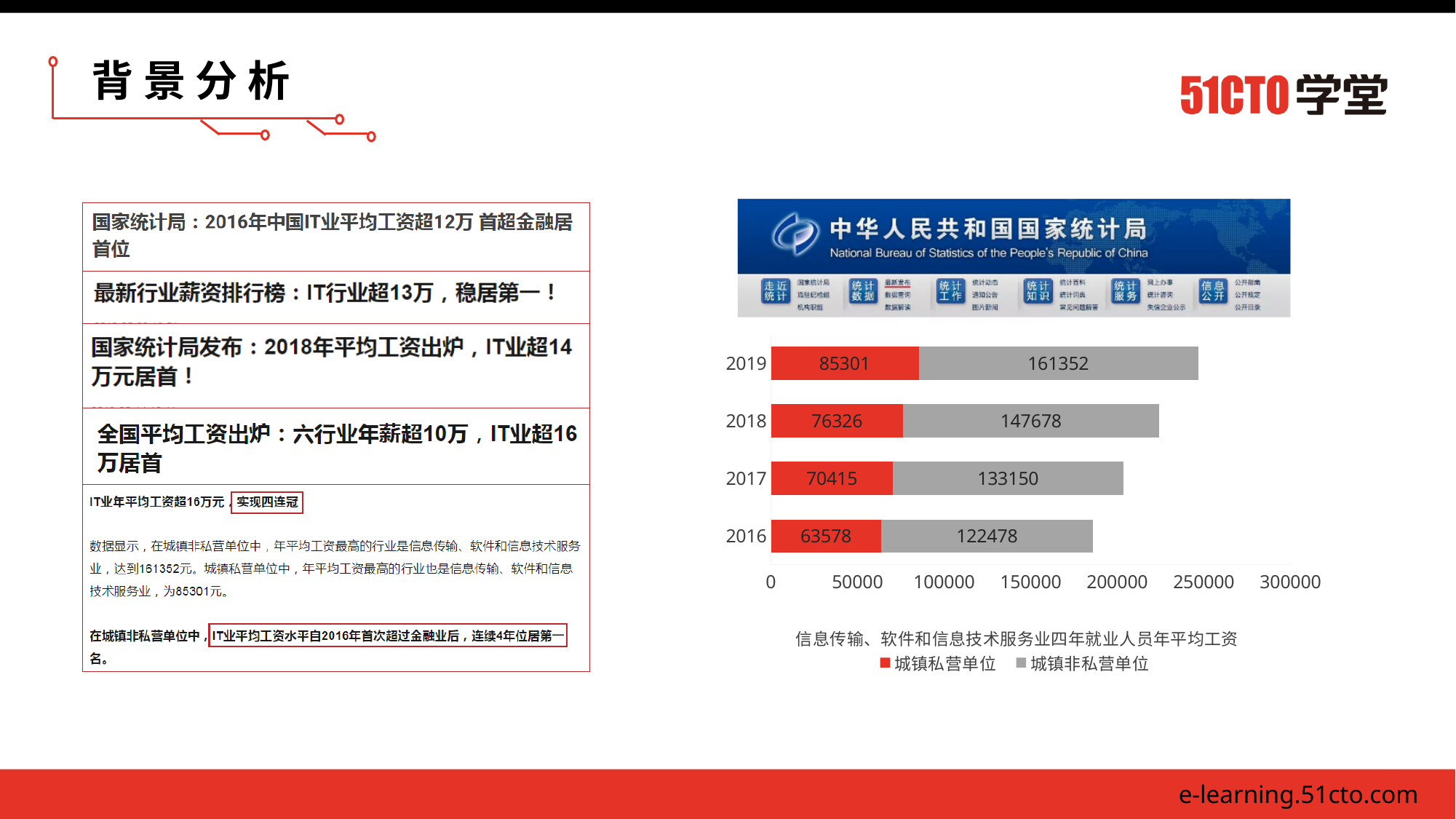
What is the total of the stacked bar for 2018? 224004 Which year has the highest value for 城镇非私营单位? 2019 What is the value for 城镇非私营单位 in 2017? 133150 How many years are shown on the chart? 4 Which is larger: 城镇私营单位 in 2018 or 城镇私营单位 in 2017? 城镇私营单位 in 2018 How many series does the legend list? 2 What is the difference between 城镇非私营单位 and 城镇私营单位 in 2019? 76051 What is the total of the stacked bar for 2016? 186056 What is the value for 城镇私营单位 in 2016? 63578 Which year has the lowest value for 城镇私营单位? 2016 What kind of chart is shown on the slide? Stacked bar chart What is the value for 城镇私营单位 in 2019? 85301